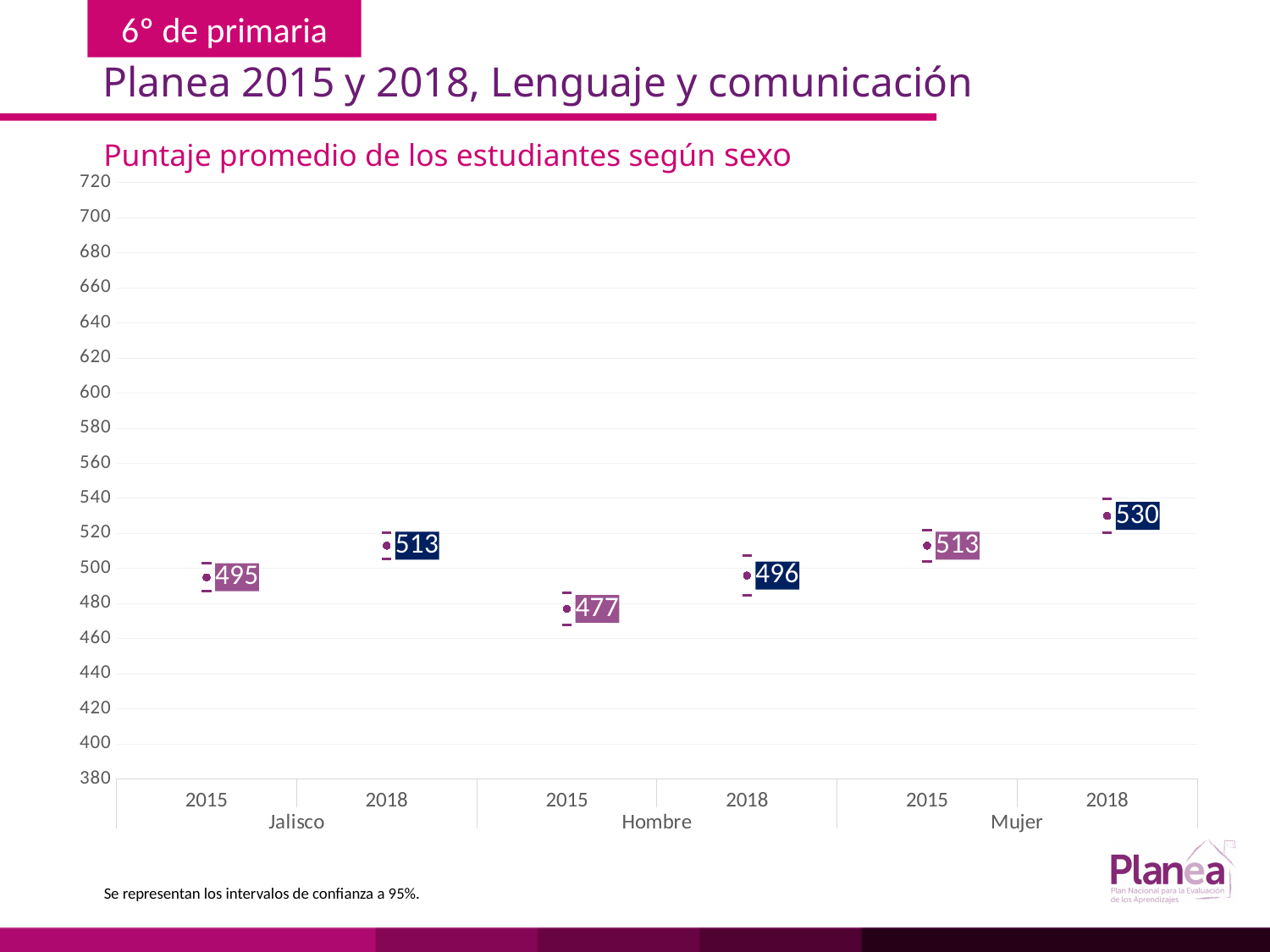
How many data points are plotted on the chart? 6 Which is larger, the Hombre 2018 score or the Mujer 2015 score? Mujer 2015 What is the average score for Hombre in 2015? 477 Which group and year has the highest average score? Mujer 2018 What is the average score for Mujer in 2018? 530 Do the scores for Hombre rise or fall from 2015 to 2018? rise What is the difference between the Jalisco 2018 score and the Jalisco 2015 score? 18 What is the average score for Hombre in 2018? 496 What is the difference between the Mujer 2018 score and the Mujer 2015 score? 17 What is the average score for Jalisco in 2015? 495 Which group and year has the lowest average score? Hombre 2015 What is the title of the chart? Puntaje promedio de los estudiantes según sexo